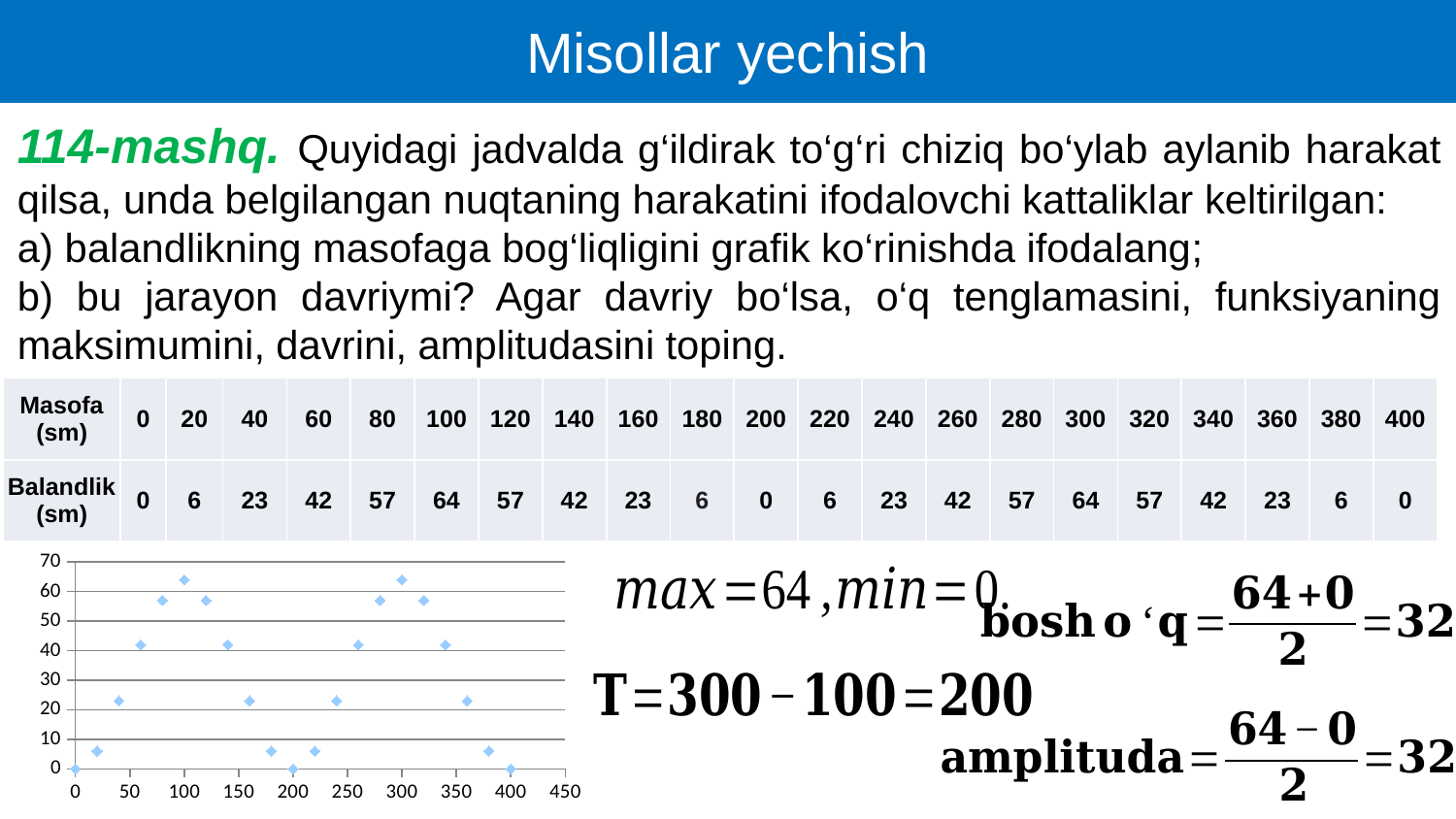
What is the maximum height value plotted in the chart? 64 At which distances (sm) does the plotted height reach its maximum of 64? 100 and 300 Is the plotted height at a distance of 40 sm greater or less than 30? less What is the height (sm) plotted at a distance of 80 sm? 57 What kind of chart is shown at the bottom left of the slide? scatter chart How many data points are plotted in the chart? 21 Is the plotted height at a distance of 120 sm greater or less than 50? greater Which is larger: the plotted height at 100 sm or at 200 sm? 100 sm What is the difference between the maximum and minimum plotted heights? 64 What is the height (sm) plotted at a distance of 260 sm? 42 Do the plotted heights rise or fall as the distance goes from 0 sm to 100 sm? rise What is the minimum height value plotted in the chart? 0